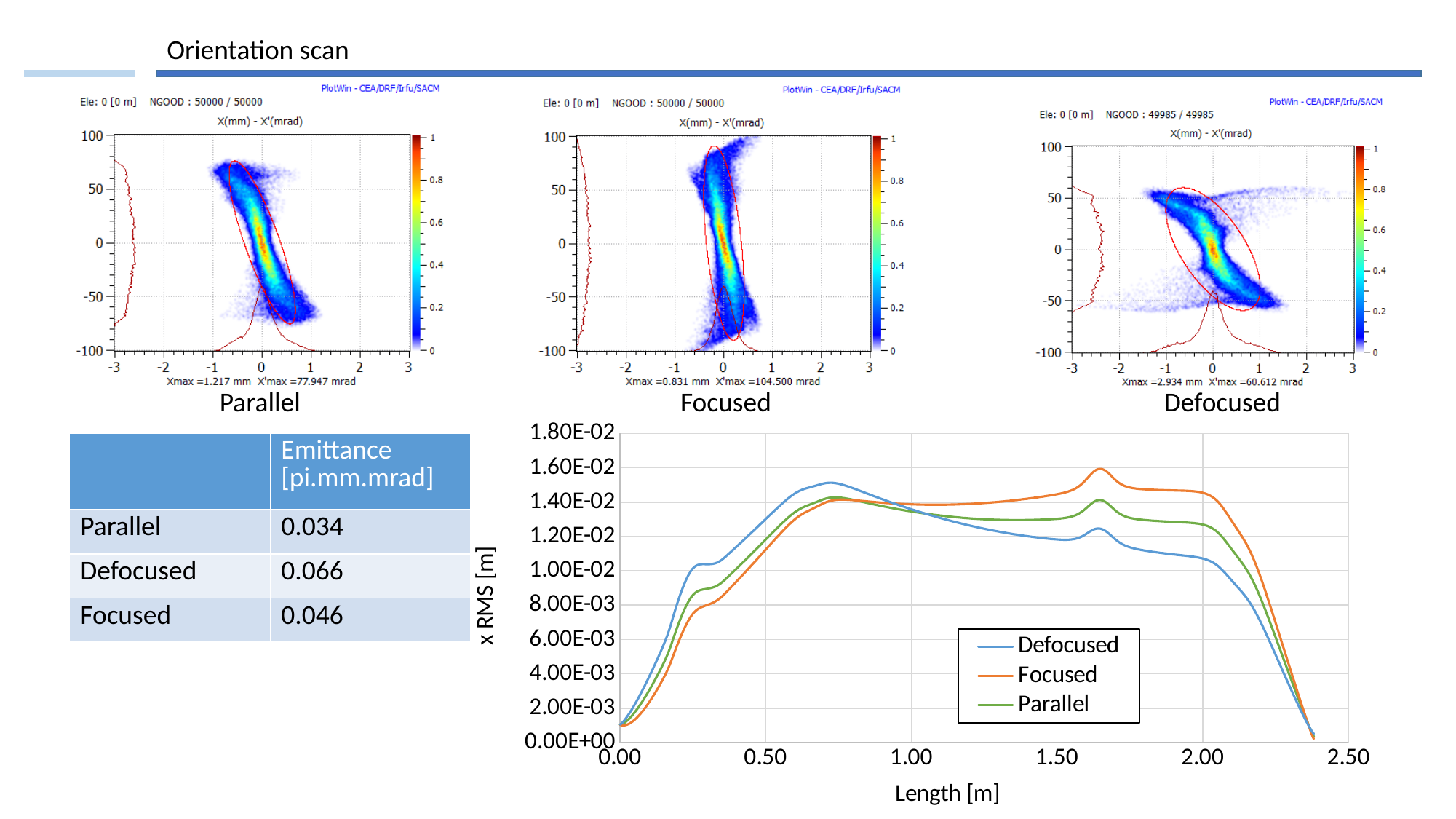
What is the label of the y axis of the x RMS versus Length chart? x RMS [m] In the x RMS versus Length chart, which series has the highest value at a length of 1.50 m? Focused In the phase-space plot labelled Focused, what is the printed X'max value? 104.500 mrad Among the three phase-space plots (Parallel, Focused, Defocused), which has the largest printed Xmax value? Defocused In the phase-space plot labelled Parallel, what is the printed Xmax value? 1.217 mm In the x RMS versus Length chart, is the peak value of the Focused series near 1.65 m greater or less than 1.40E-02? greater In the x RMS versus Length chart, is the value of the Defocused series at 2.00 m greater or less than 1.20E-02? less In the x RMS versus Length chart, which series has the highest value at a length of 0.50 m? Defocused In the x RMS versus Length chart, which series has the lowest value at a length of 1.50 m? Defocused What kind of chart is the x RMS versus Length chart at the bottom right of the slide? line chart How many series does the legend of the x RMS versus Length chart list? 3 In the x RMS versus Length chart, do all three series rise or fall between 2.00 m and 2.40 m? fall